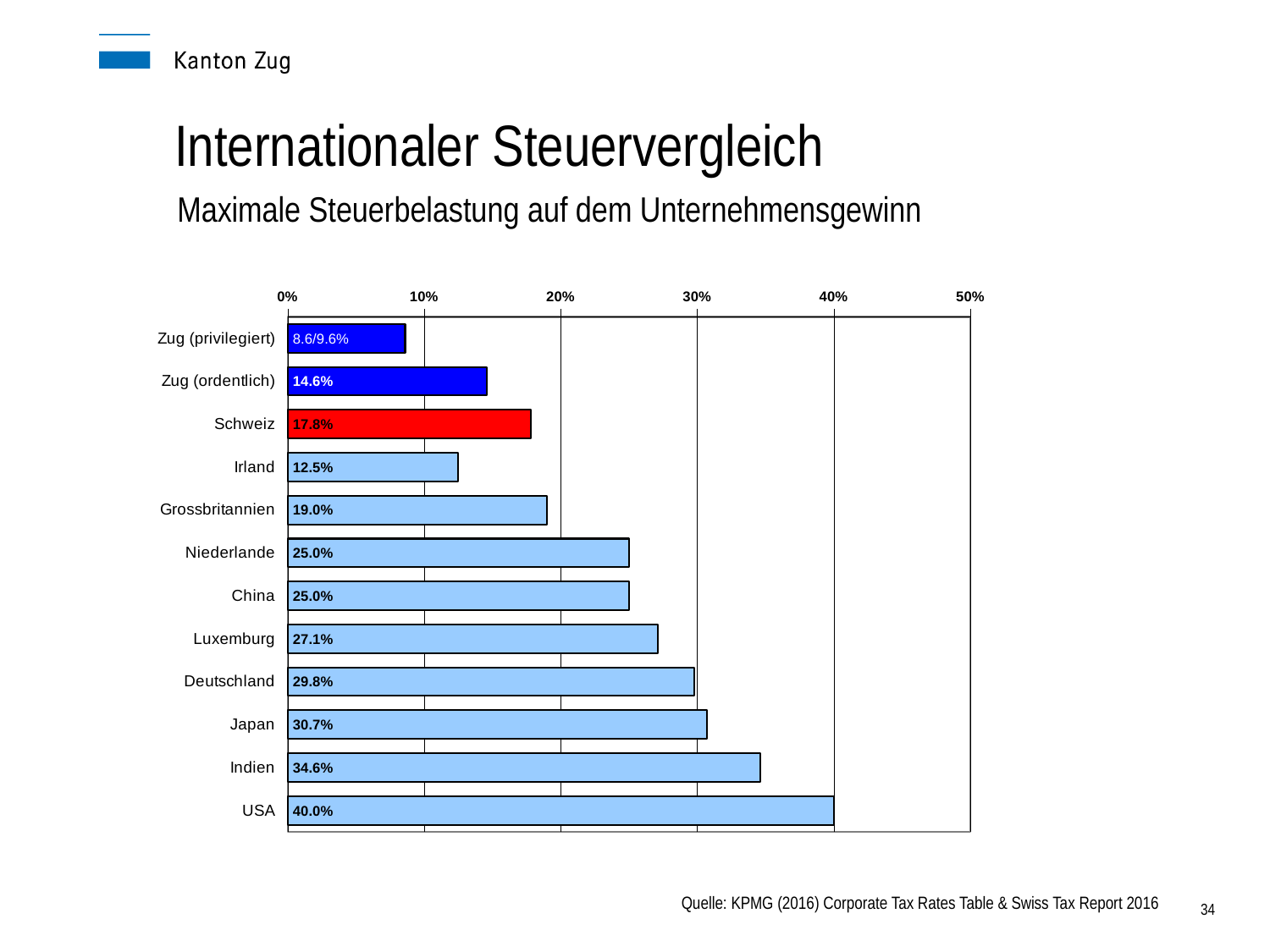
What is the value for Irland? 12.5% How many categories are shown in the chart? 12 What is the data label shown for Zug (privilegiert)? 8.6/9.6% Which is larger, the value for Deutschland or the value for Luxemburg? Deutschland What is the value for Schweiz? 17.8% What is the value for Japan? 30.7% Which category has the lowest value? Zug (privilegiert) What is the difference between the values for Schweiz and Zug (ordentlich)? 3.2% What is the difference between the values for USA and Indien? 5.4% Is the value for Indien greater or less than 30%? greater Which category has the highest value? USA What kind of chart is shown on the slide? bar chart